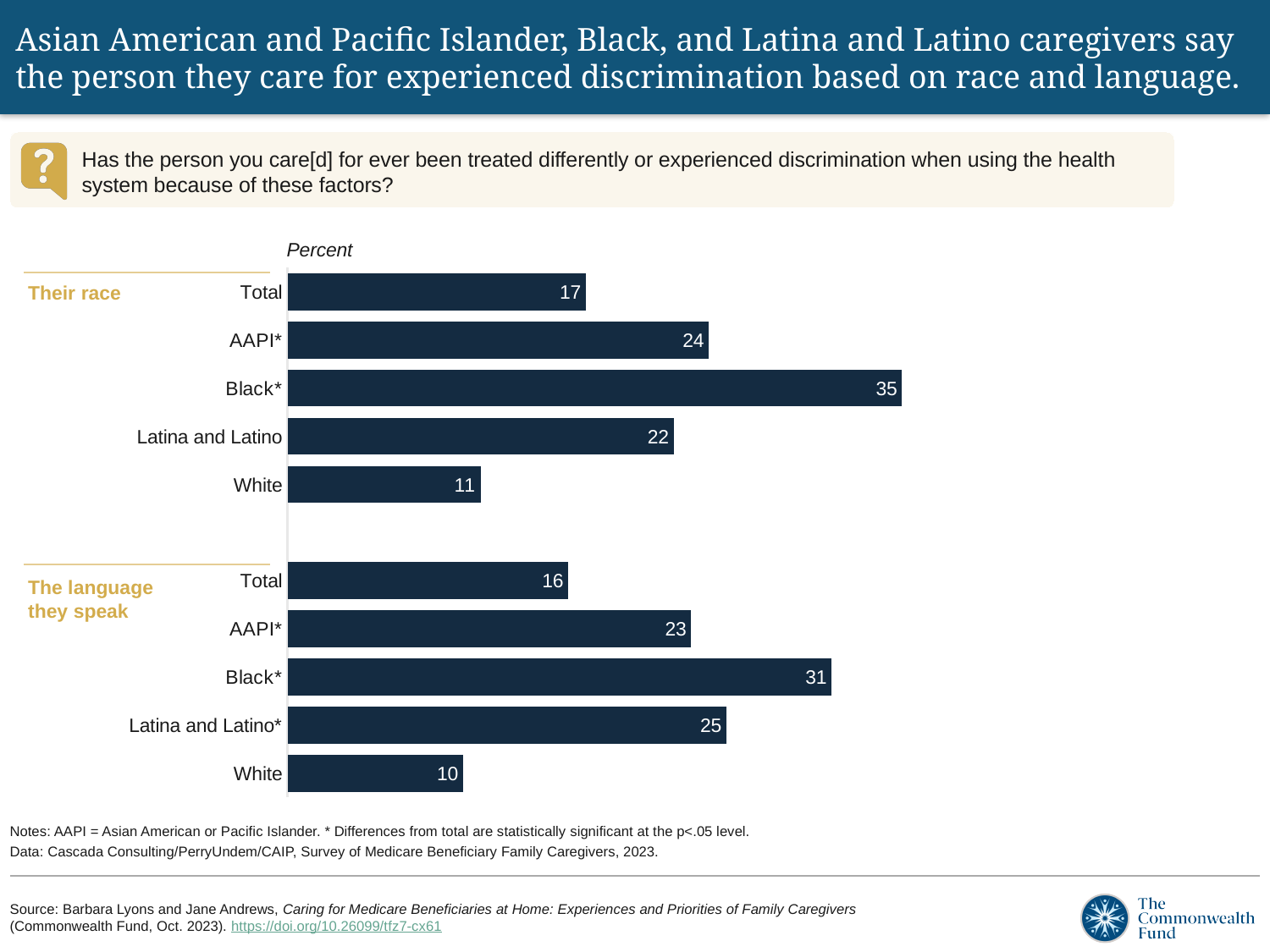
What kind of chart is shown on the slide? Bar chart In the "The language they speak" group, which category has the highest value? Black* Which is larger: the value for AAPI* in the "Their race" group or the value for Latina and Latino* in the "The language they speak" group? Latina and Latino* in the "The language they speak" group In the "Their race" group, what is the value for White? 11 In the "Their race" group, what is the difference between the values for Black* and White? 24 What unit label is shown above the bars? Percent How many bars are plotted on the slide in total? 10 In the "The language they speak" group, what is the difference between the values for Latina and Latino* and Total? 9 How many bars are shown in the "Their race" group? 5 In the "The language they speak" group, what is the value for AAPI*? 23 In the "Their race" group, which category has the lowest value? White In the "Their race" group, what is the value for Black*? 35